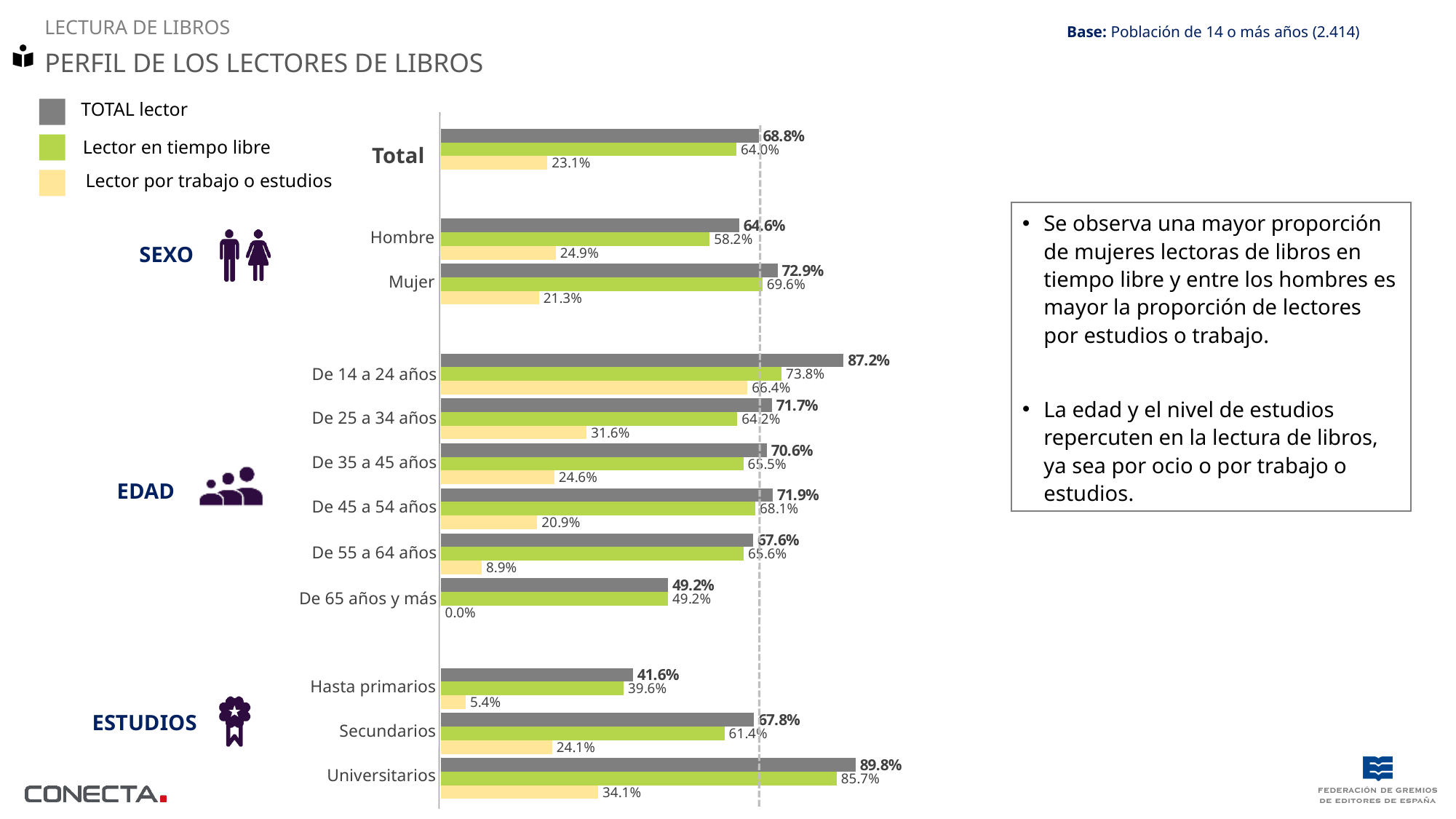
Which category has the lowest Lector por trabajo o estudios value? De 65 años y más What is the TOTAL lector value for Universitarios? 89.8% What is the Lector en tiempo libre value for Mujer? 69.6% Which colour represents the Lector en tiempo libre series? Green What kind of chart is shown on the slide? Bar chart How many series does the legend list? 3 Which is larger, the Lector por trabajo o estudios value for Hombre or for Mujer? Hombre What is the Lector por trabajo o estudios value for De 14 a 24 años? 66.4% What is the difference between the Lector en tiempo libre values for Universitarios and Hasta primarios? 46.1% How many categories are plotted on the chart? 12 What is the difference between the TOTAL lector values for Mujer and Hombre? 8.3% Which category has the highest TOTAL lector value? Universitarios